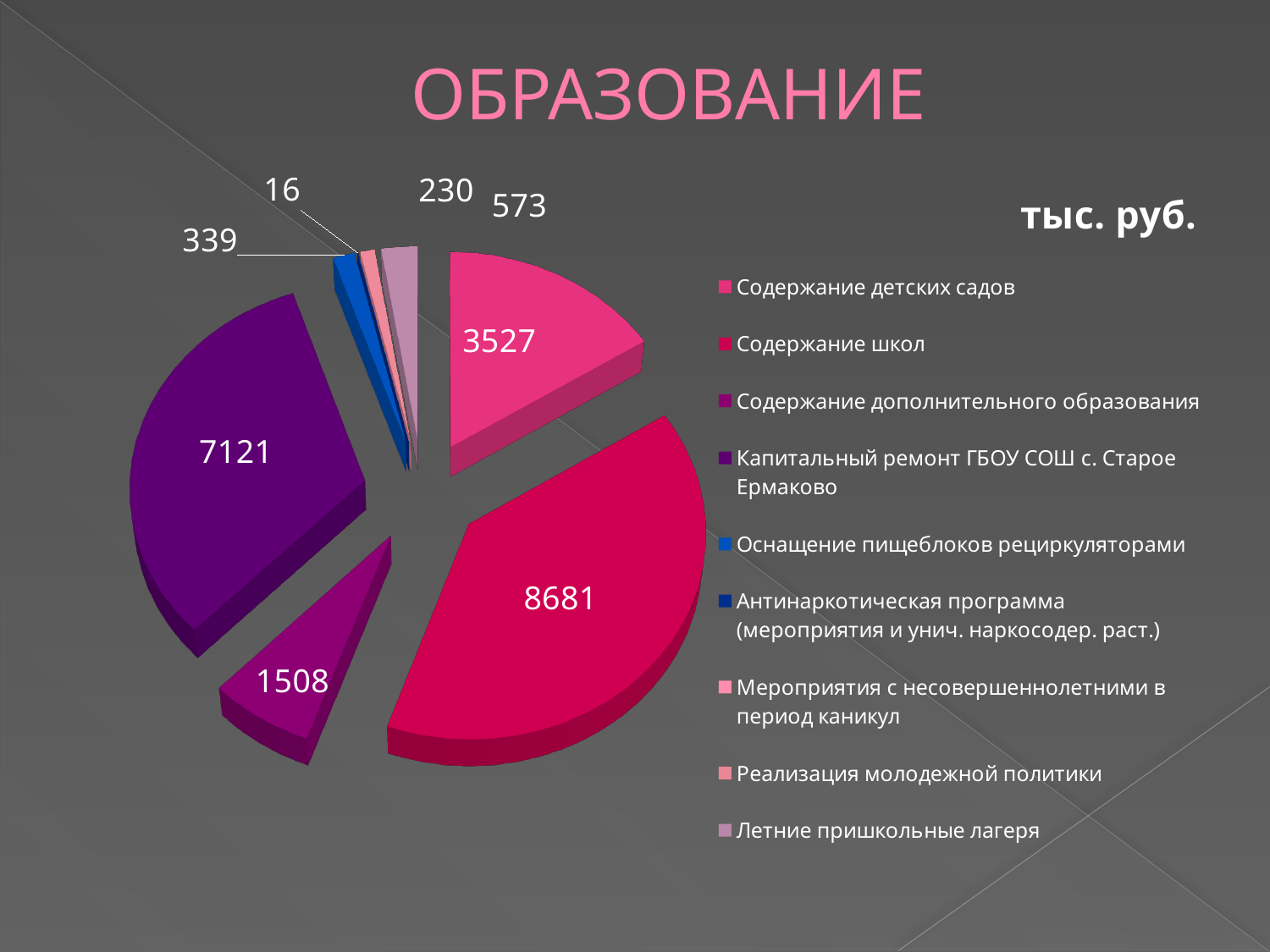
What is the value for Содержание детских садов? 3527 What is the difference between the values for Содержание школ and Содержание детских садов? 5154 What is the value for Содержание школ? 8681 What is the value for Оснащение пищеблоков рециркуляторами? 339 How many entries does the legend list? 9 Which category has the largest slice of the pie? Содержание школ What is the value for Содержание дополнительного образования? 1508 What is the difference between the values for Содержание школ and Капитальный ремонт ГБОУ СОШ с. Старое Ермаково? 1560 What unit is indicated for the chart values? тыс. руб. What kind of chart is shown on the slide? pie chart What is the value for Капитальный ремонт ГБОУ СОШ с. Старое Ермаково? 7121 Which is larger, the value for Капитальный ремонт ГБОУ СОШ с. Старое Ермаково or the value for Содержание детских садов? Капитальный ремонт ГБОУ СОШ с. Старое Ермаково